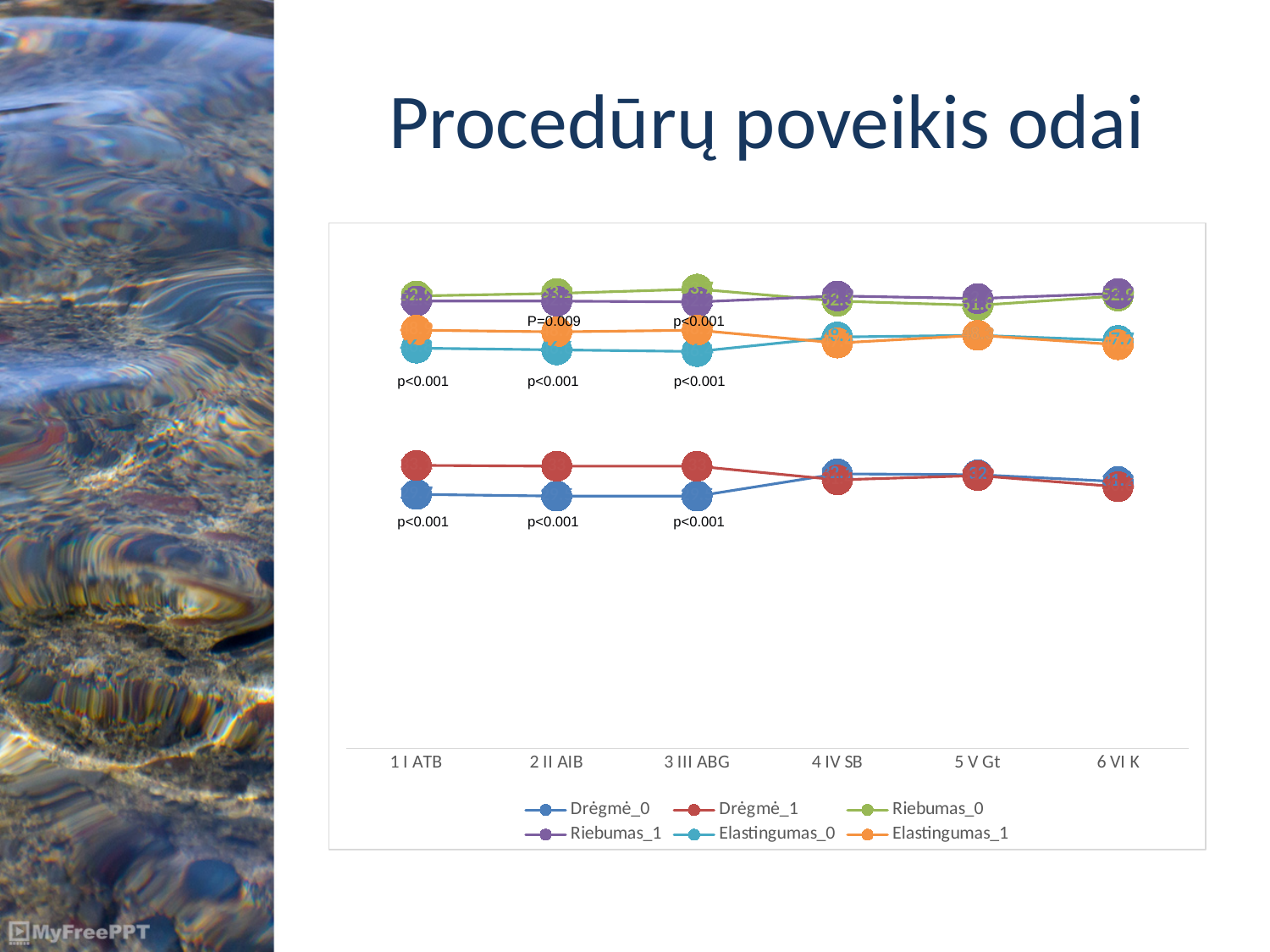
At 1 I ATB, which series has the higher value: Riebumas_0 or Drėgmė_1? Riebumas_0 At 1 I ATB, which series has the higher value: Elastingumas_0 or Elastingumas_1? Elastingumas_1 Does the Drėgmė_0 series rise or fall between 3 III ABG and 4 IV SB? rise What kind of chart is shown on the slide? line chart What is the first category on the x axis of the chart? 1 I ATB What is the last category on the x axis of the chart? 6 VI K How many series does the chart's legend list? 6 At 1 I ATB, which series has the higher value: Drėgmė_0 or Drėgmė_1? Drėgmė_1 How many categories are shown on the x axis of the chart? 6 Does the Elastingumas_1 series rise or fall between 5 V Gt and 6 VI K? fall